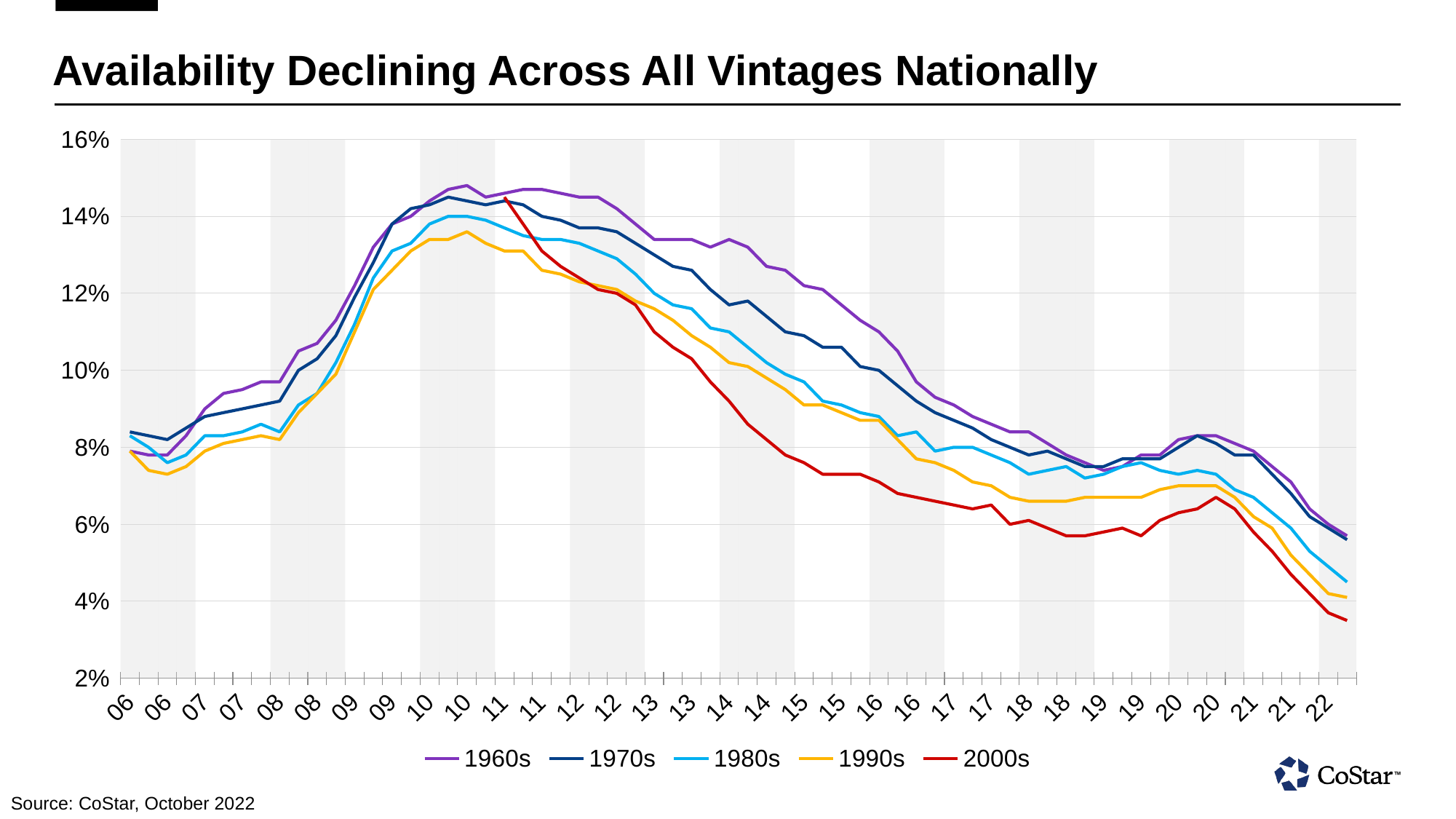
Is the value for the 1970s series at the end of 2022 greater or less than 6%? less Is the value for the 1980s series at the end of 2022 greater or less than 4%? greater How many series does the legend list? 5 Is the value for the 2000s series at the end of 2022 greater or less than 4%? less Which series has the lowest value at the end of 2022? 2000s Which series has the lowest value in 2015? 2000s Which series is drawn in red? 2000s Does the 1960s series rise or fall from 2010 to 2022? fall At the end of 2022, which is higher: the 1960s series or the 2000s series? 1960s What is the title of the chart? Availability Declining Across All Vintages Nationally What kind of chart is shown on the slide? line chart